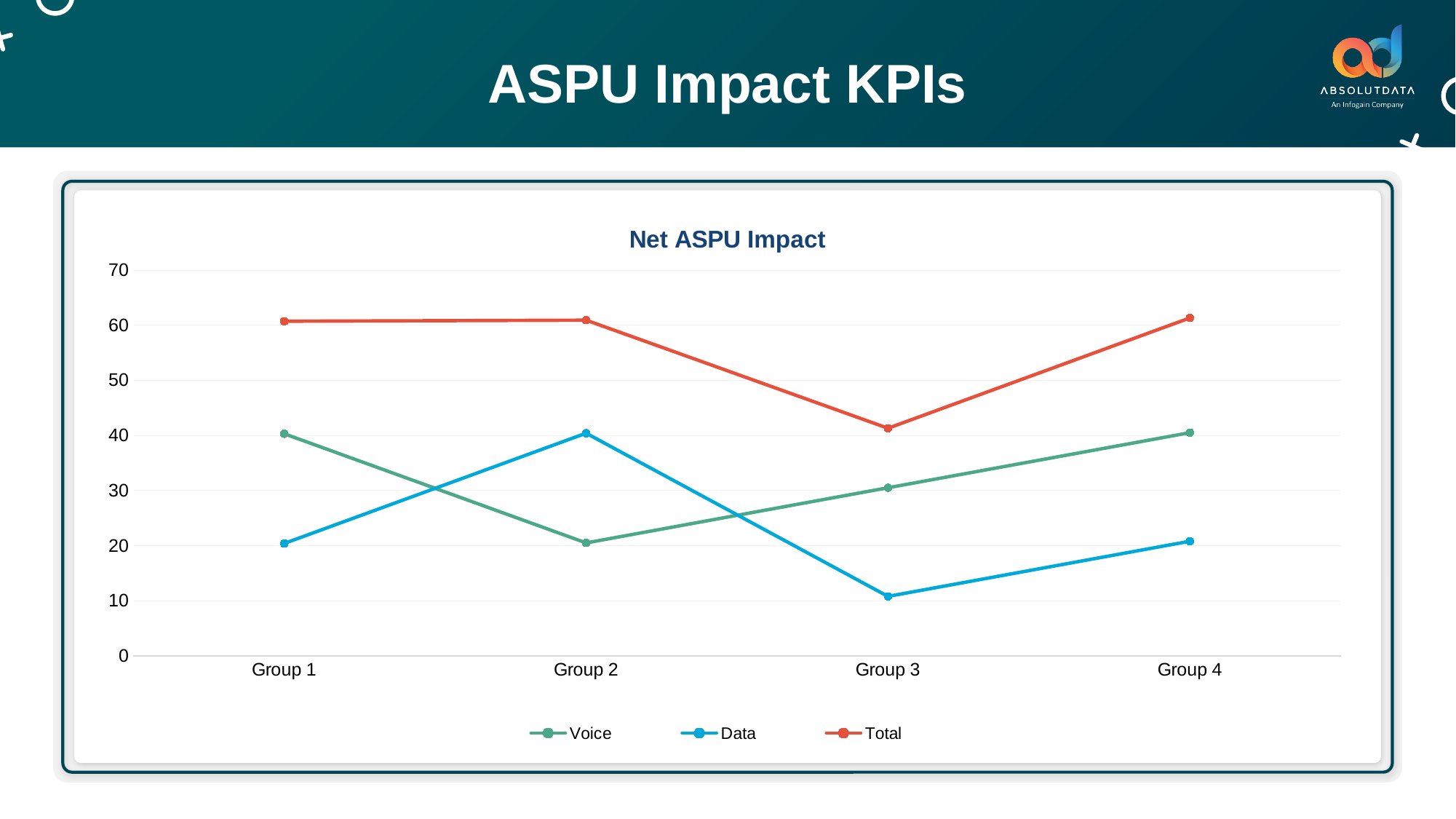
Which group has the lowest value for the Data series? Group 3 Which group has the lowest value for the Voice series? Group 2 Which group has the lowest value for the Total series? Group 3 How many groups are shown on the x axis? 4 At Group 2, which is larger, Voice or Data? Data Is the Total value for Group 3 greater or less than 50? less Which group has the highest value for the Data series? Group 2 Is the Data value for Group 3 greater or less than 20? less How many series does the legend list? 3 What kind of chart is shown on the slide? line chart What is the title of the chart? Net ASPU Impact Does the Total series rise or fall from Group 2 to Group 3? fall